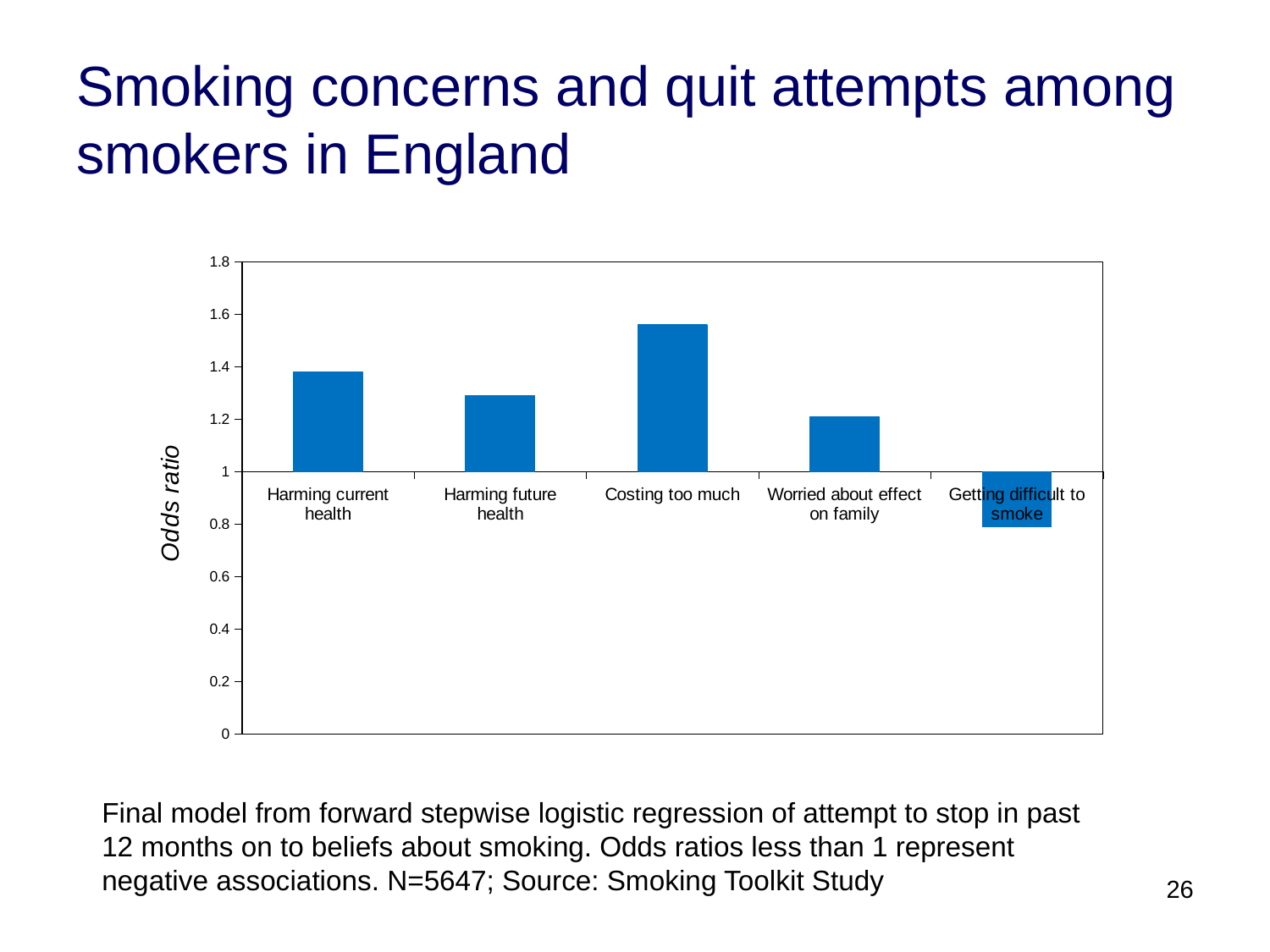
Which has a larger odds ratio, Worried about effect on family or Costing too much? Costing too much Which is the only category whose bar extends below the baseline of 1? Getting difficult to smoke How many categories are plotted in the chart? 5 Is the odds ratio for Harming future health greater or less than 1.2? greater What kind of chart is shown on the slide? bar chart Is the odds ratio for Getting difficult to smoke greater or less than 1? less Which has a larger odds ratio, Harming current health or Harming future health? Harming current health Which category has the lowest odds ratio? Getting difficult to smoke Which category has the highest odds ratio? Costing too much What is the label on the vertical axis of the chart? Odds ratio Is the odds ratio for Costing too much greater or less than 1.4? greater